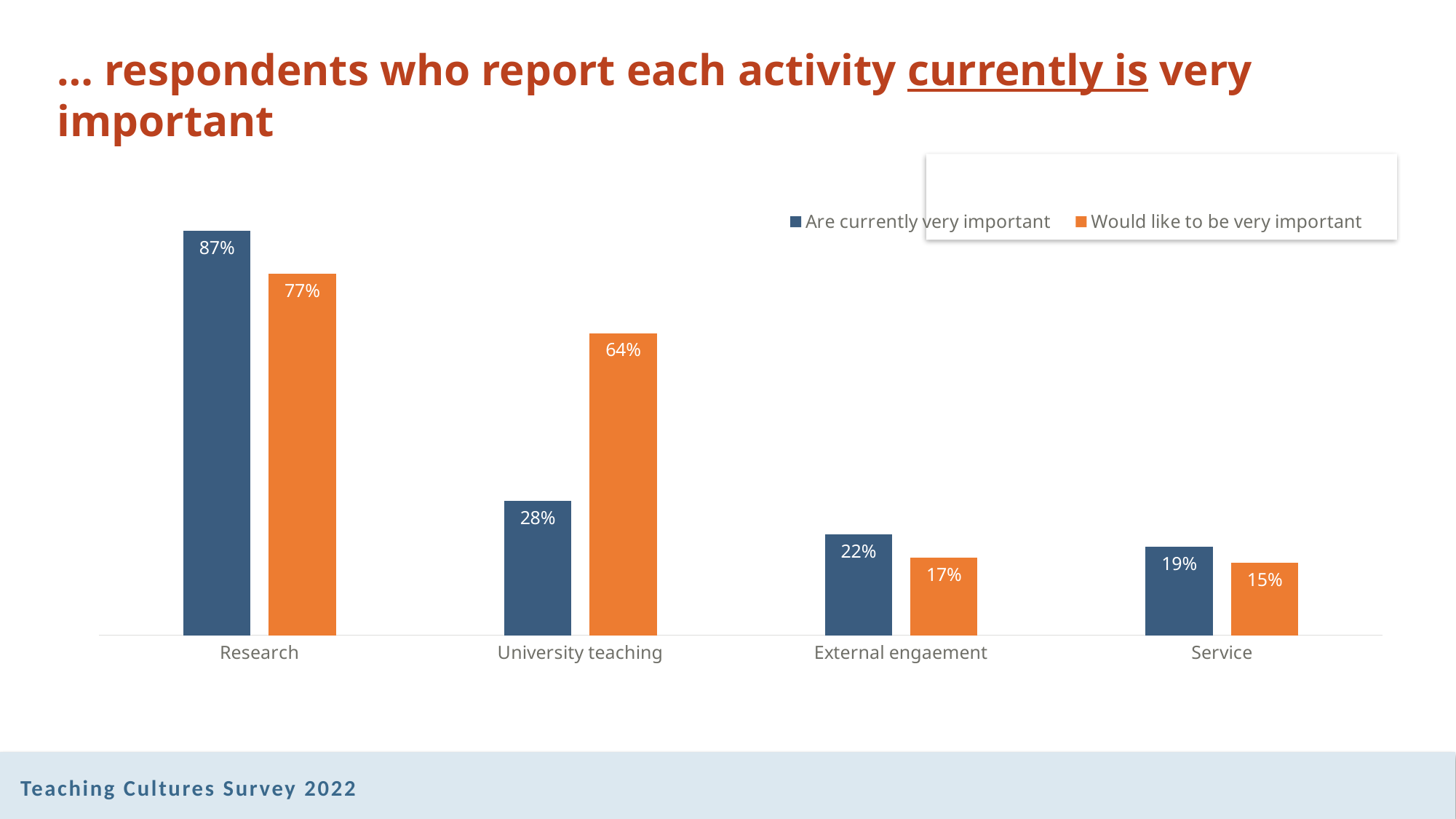
Which activity has the lowest value for 'Would like to be very important'? Service How many series does the legend list? 2 For External engaement, which is larger: 'Are currently very important' or 'Would like to be very important'? Are currently very important What is the difference between the 'Would like to be very important' and 'Are currently very important' values for University teaching? 36 percentage points What is the difference between the 'Are currently very important' values for Research and Service? 68 percentage points Which activity has the highest value for 'Are currently very important'? Research What is the value for Service in the 'Are currently very important' series? 19% What is the value for University teaching in the 'Would like to be very important' series? 64% What kind of chart is shown on the slide? Bar chart Which colour represents the 'Would like to be very important' series? Orange What percentage of respondents report that Research is currently very important? 87% How many activity categories are shown on the x axis? 4